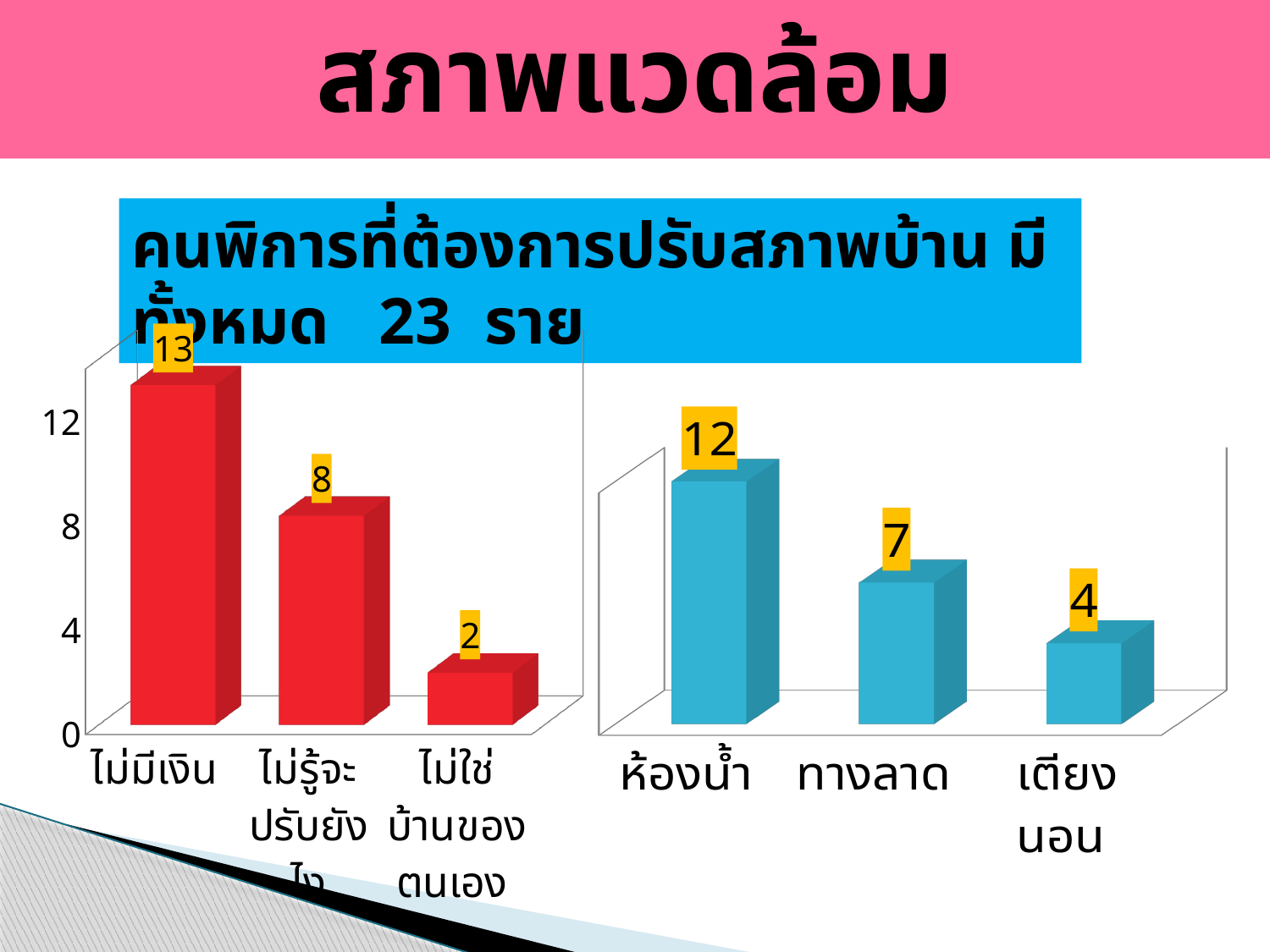
In the right chart (blue bars), which category has the lowest value? เตียงนอน How many categories are shown in the left chart (red bars)? 3 What kind of chart is the right chart (blue bars)? bar chart In the left chart (red bars), which category has the highest value? ไม่มีเงิน In the right chart (blue bars), what is the difference between the values for ห้องน้ำ and เตียงนอน? 8 In the left chart (red bars), what is the value for ไม่มีเงิน? 13 In the right chart (blue bars), which is larger, the value for ห้องน้ำ or the value for ทางลาด? ห้องน้ำ In the left chart (red bars), what is the difference between the values for ไม่มีเงิน and ไม่รู้จะปรับยังไง? 5 In the right chart (blue bars), what is the value for ทางลาด? 7 In the left chart (red bars), what is the value for ไม่ใช่บ้านของตนเอง? 2 In the right chart (blue bars), do the values rise or fall from left to right along the x axis? fall In the right chart (blue bars), what is the value for เตียงนอน? 4